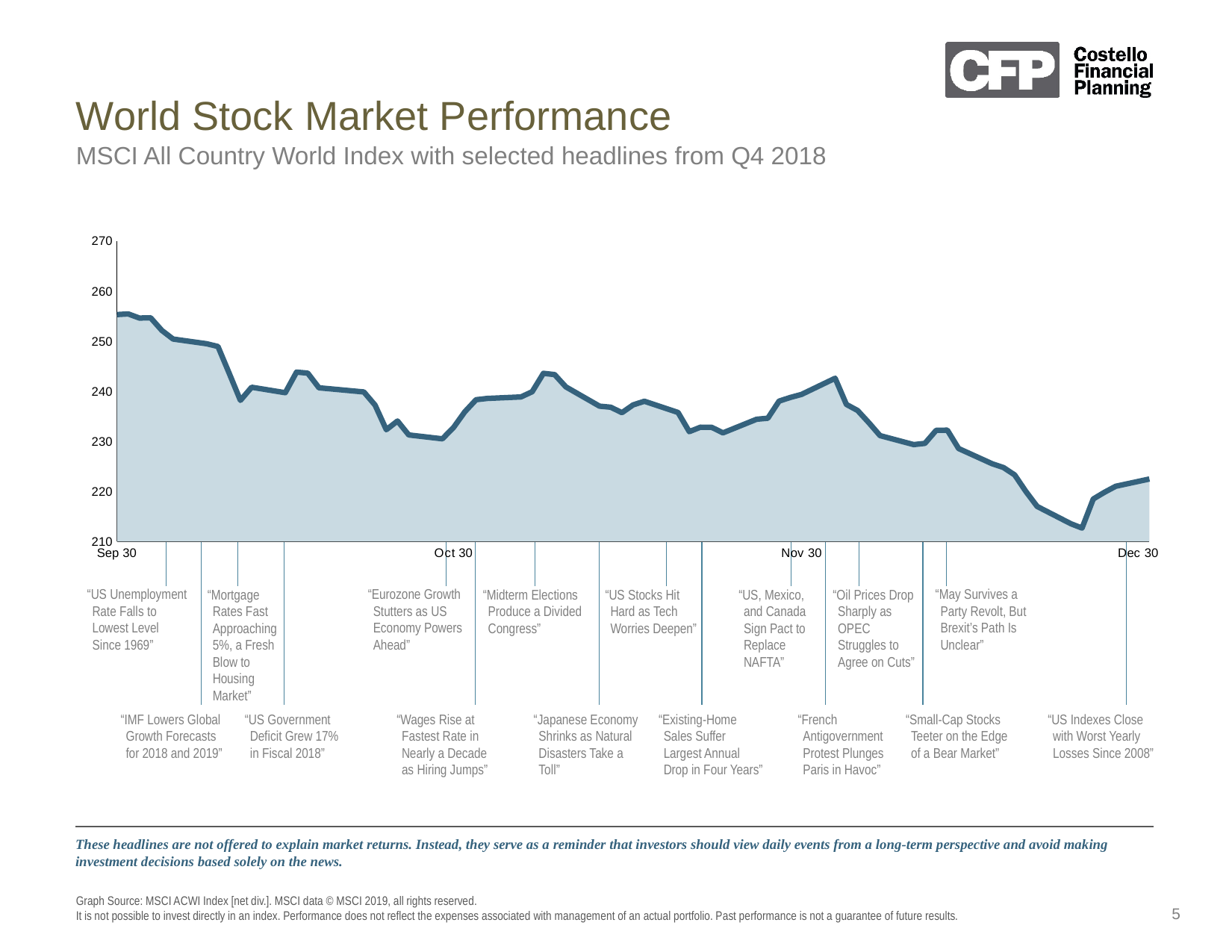
What kind of chart is shown on the slide? Area chart Which index does the chart plot, according to the subtitle? MSCI All Country World Index Which of the four labelled dates on the x axis has the highest index value: Sep 30 or Dec 30? Sep 30 Overall, does the index rise or fall from Sep 30 to Dec 30? Fall How many date labels are shown on the x axis? 4 What is the highest value shown on the y axis? 270 Is the lowest point of the index in the quarter greater or less than 220? less What is the title of the chart on the slide? World Stock Market Performance Is the value of the index at Nov 30 greater or less than 230? greater Is the value of the index at Dec 30 greater or less than 230? less